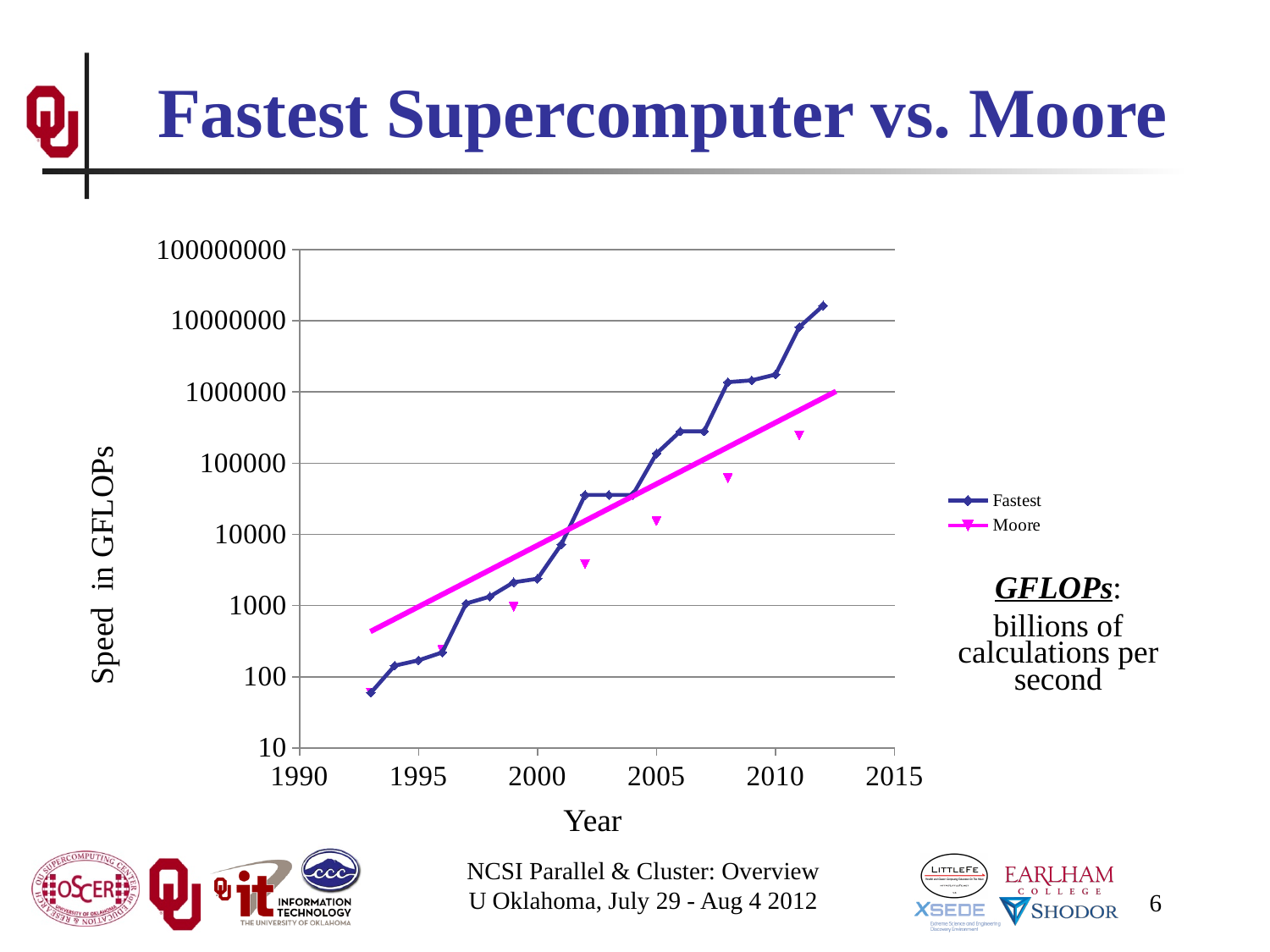
How many series does the legend list? 2 Does the Fastest series rise or fall as the year increases? rise Is the Fastest value for 2010 greater or less than 1000000? greater Is the Moore value for 2002 greater or less than 10000? less What kind of chart is shown on the slide? line chart In 2008, which series has the larger value, Fastest or Moore? Fastest In 2011, which series has the larger value, Fastest or Moore? Fastest Is the Fastest value for 2012 greater or less than 10000000? greater What is the label on the vertical axis? Speed in GFLOPs What are the two series named in the legend? Fastest and Moore